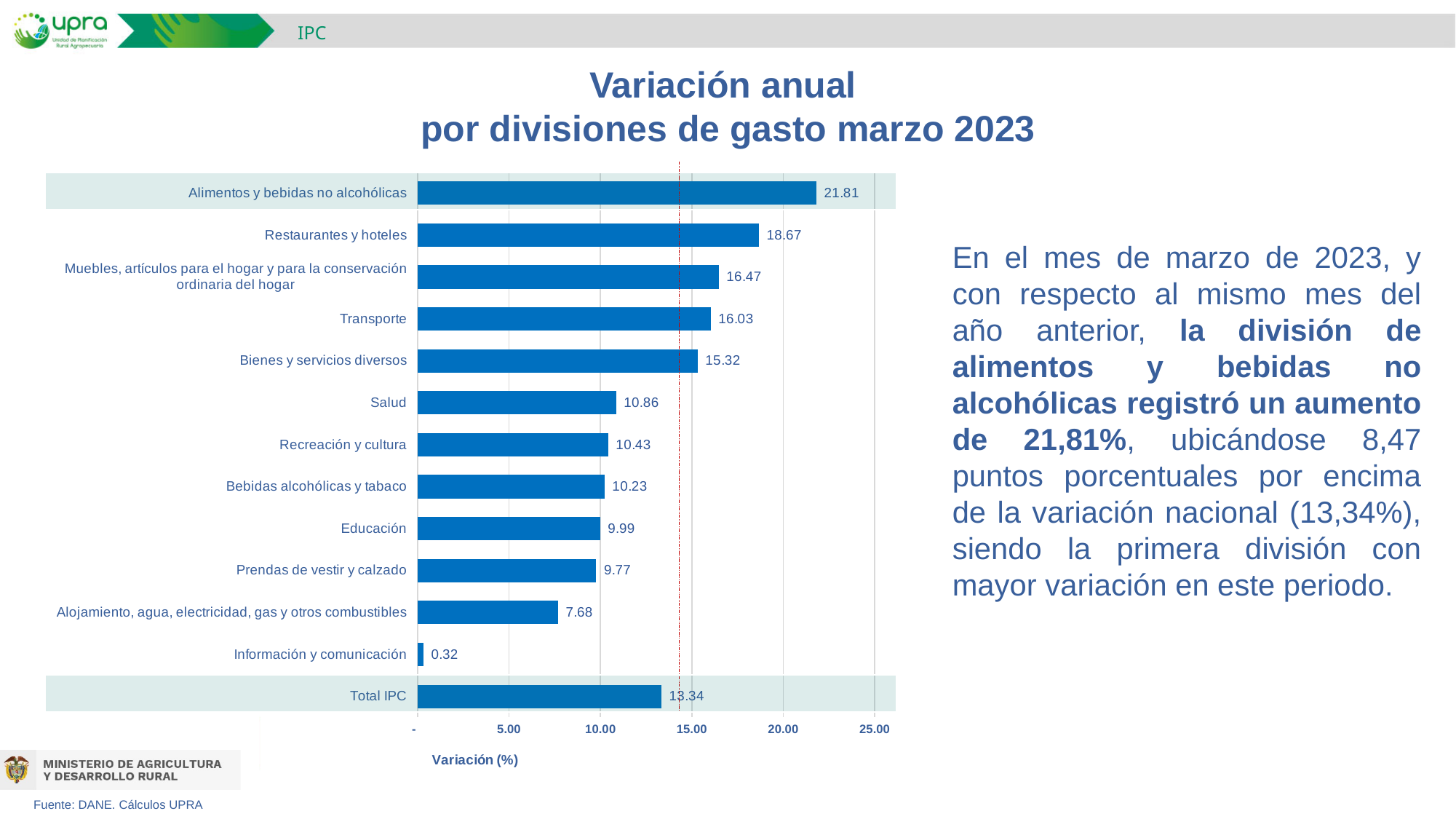
What is the label of the horizontal axis? Variación (%) Is the value for Bienes y servicios diversos greater or less than 15.00? greater Which division has the highest annual variation? Alimentos y bebidas no alcohólicas What is the annual variation for Alimentos y bebidas no alcohólicas? 21.81 What is the annual variation for Transporte? 16.03 What is the annual variation for Información y comunicación? 0.32 What is the difference between the values for Alimentos y bebidas no alcohólicas and Total IPC? 8.47 What kind of chart is shown on the slide? Bar chart What is the value shown for Total IPC? 13.34 Which has a larger annual variation, Restaurantes y hoteles or Salud? Restaurantes y hoteles Which division has the lowest annual variation? Información y comunicación How many bars are shown in the chart, including Total IPC? 13